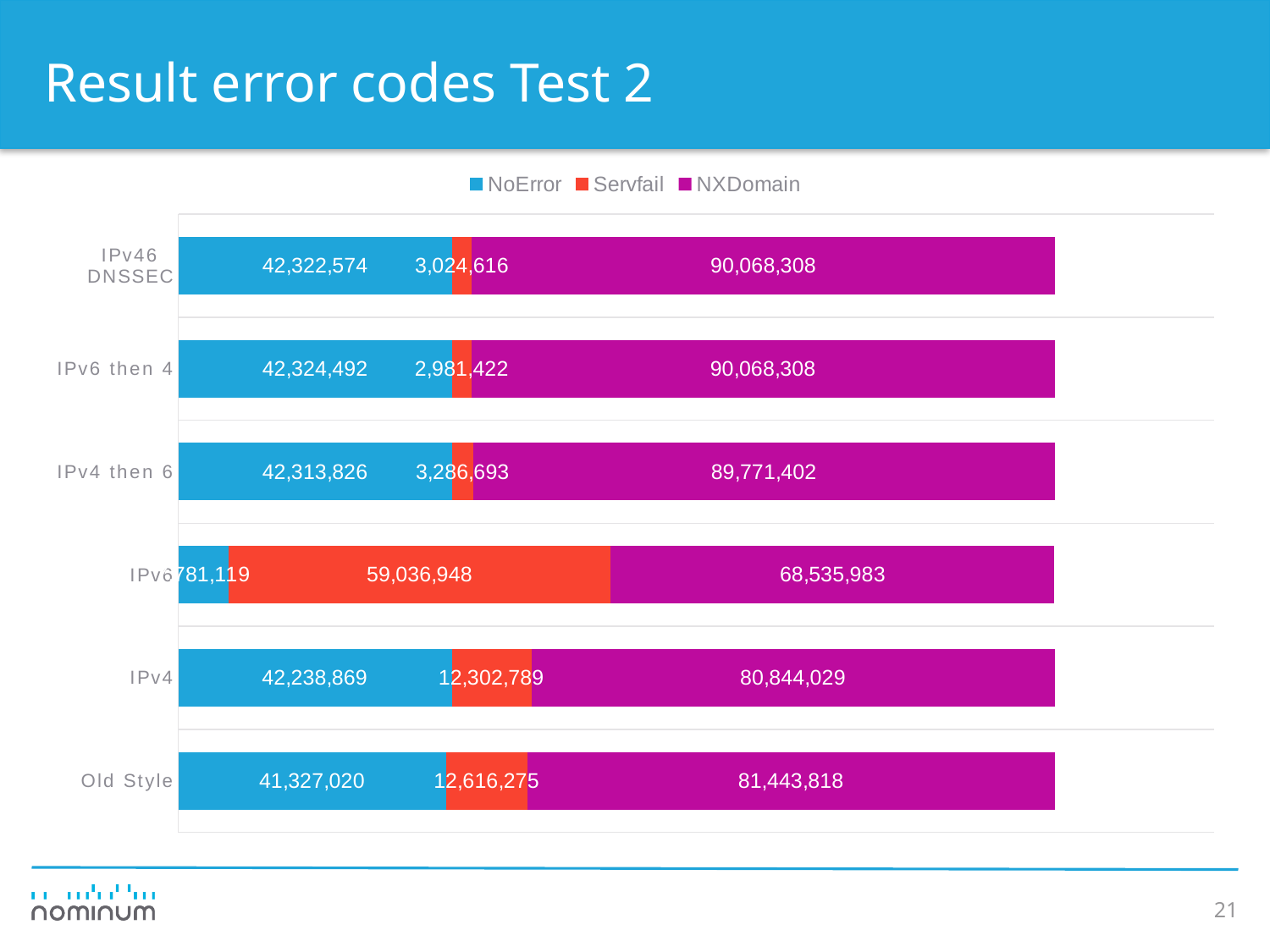
What is the title of the slide? Result error codes Test 2 What is the NXDomain value for Old Style? 81,443,818 What is the Servfail value for IPv6? 59,036,948 Which is larger, the NXDomain value for IPv4 then 6 or the NXDomain value for IPv6? IPv4 then 6 How many series does the legend list? 3 Which category has the lowest NoError value? IPv6 What is the difference between the Servfail values for IPv6 and IPv4? 46,734,159 What type of chart is shown on the slide? Stacked bar chart What is the NoError value for IPv46 DNSSEC? 42,322,574 How many categories are plotted on the chart? 6 What is the total of the stacked bar for IPv6? 135,354,050 Which category has the highest Servfail value? IPv6